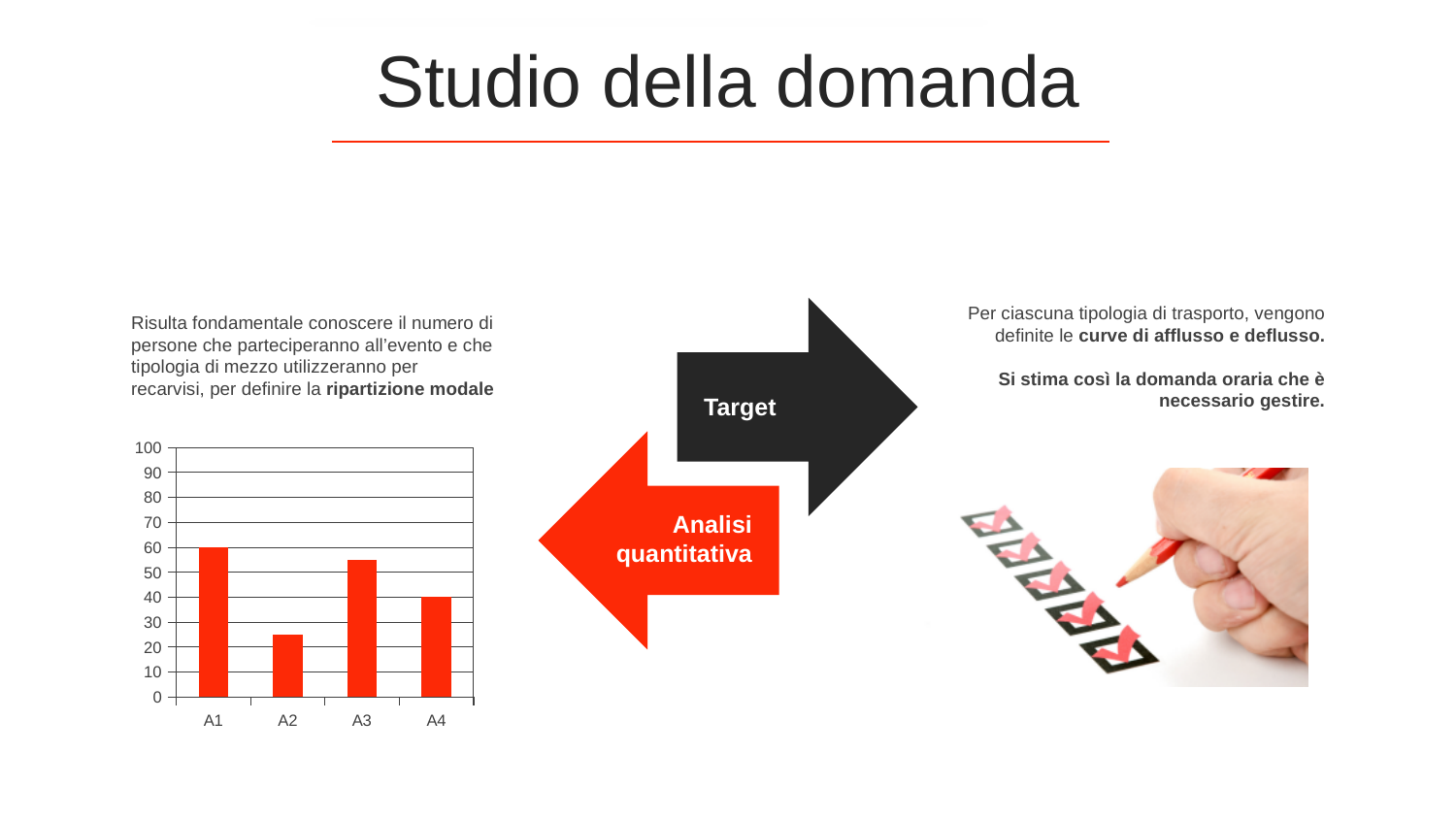
What is the difference between the values for A1 and A4? 20 What is the value for A4 in the chart? 40 Which is larger, the value for A1 or the value for A3? A1 What is the highest value shown on the y axis of the chart? 100 Is the value for A2 greater or less than 30? less Which category has the highest bar in the chart? A1 What is the value for A1 in the chart? 60 Which is larger, the value for A3 or the value for A4? A3 Which category has the lowest bar in the chart? A2 How many categories are shown on the x axis of the chart? 4 Is the value for A3 greater or less than 50? greater What kind of chart is shown on the slide? bar chart